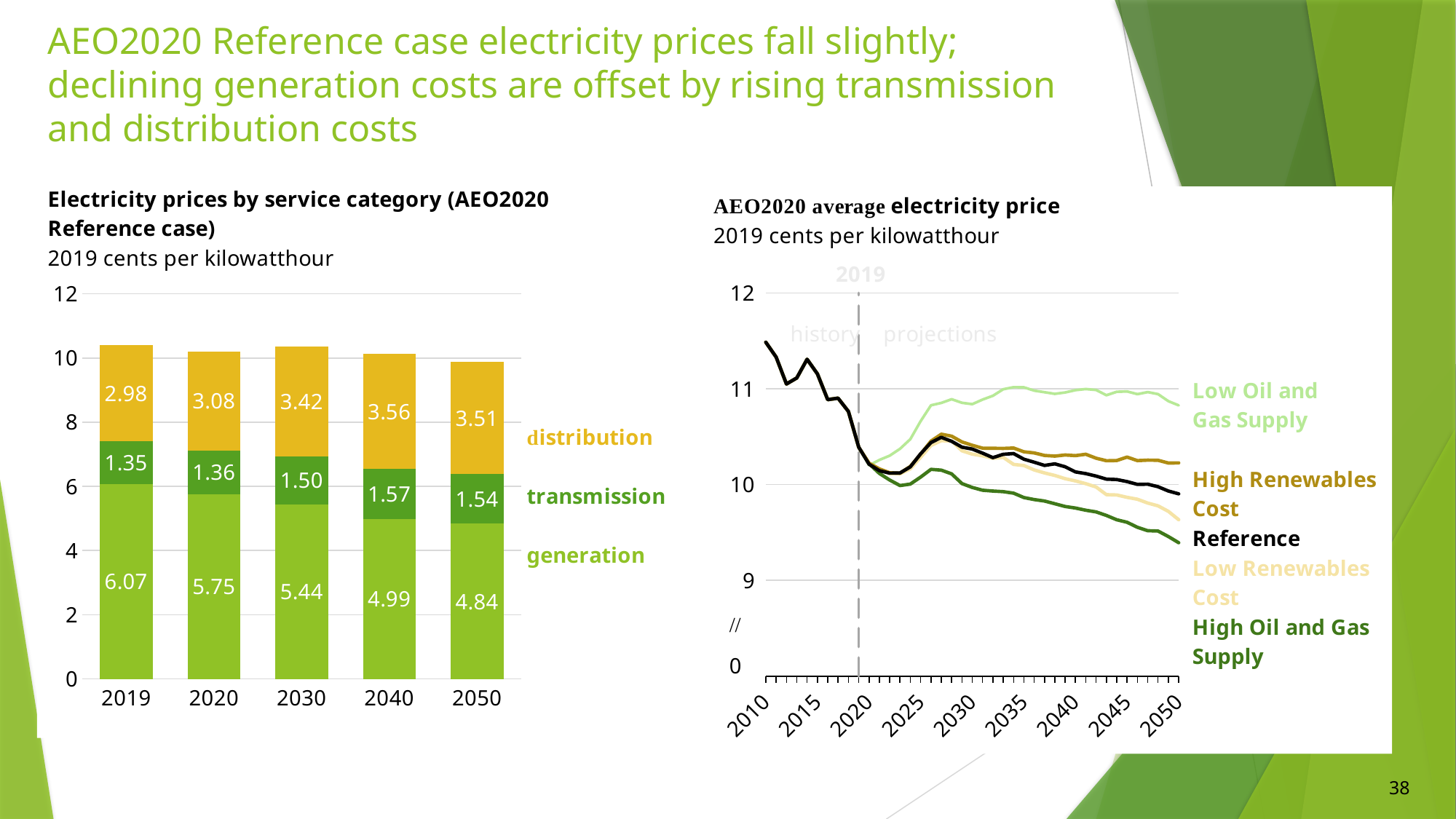
In the 'Electricity prices by service category' chart, how does the generation value change from 2019 to 2050? It falls In the 'Electricity prices by service category' chart, what is the total of the stacked bar for 2050? 9.89 In the 'AEO2020 average electricity price' chart, is the Low Oil and Gas Supply value in 2050 greater or less than 10? greater How many series are shown in the 'AEO2020 average electricity price' chart? 5 In the 'Electricity prices by service category' chart, which year has the highest generation value? 2019 In the 'Electricity prices by service category' chart, what is the distribution value for 2040? 3.56 What kind of chart is the 'AEO2020 average electricity price' chart? Line chart In the 'Electricity prices by service category' chart, what is the difference between the generation values for 2019 and 2050? 1.23 In the 'Electricity prices by service category' chart, which year has the lowest distribution value? 2019 In the 'Electricity prices by service category' chart, is the distribution value for 2020 larger or smaller than the distribution value for 2030? smaller In the 'Electricity prices by service category' chart, what is the generation value for 2019? 6.07 In the 'Electricity prices by service category' chart, what is the transmission value for 2030? 1.50